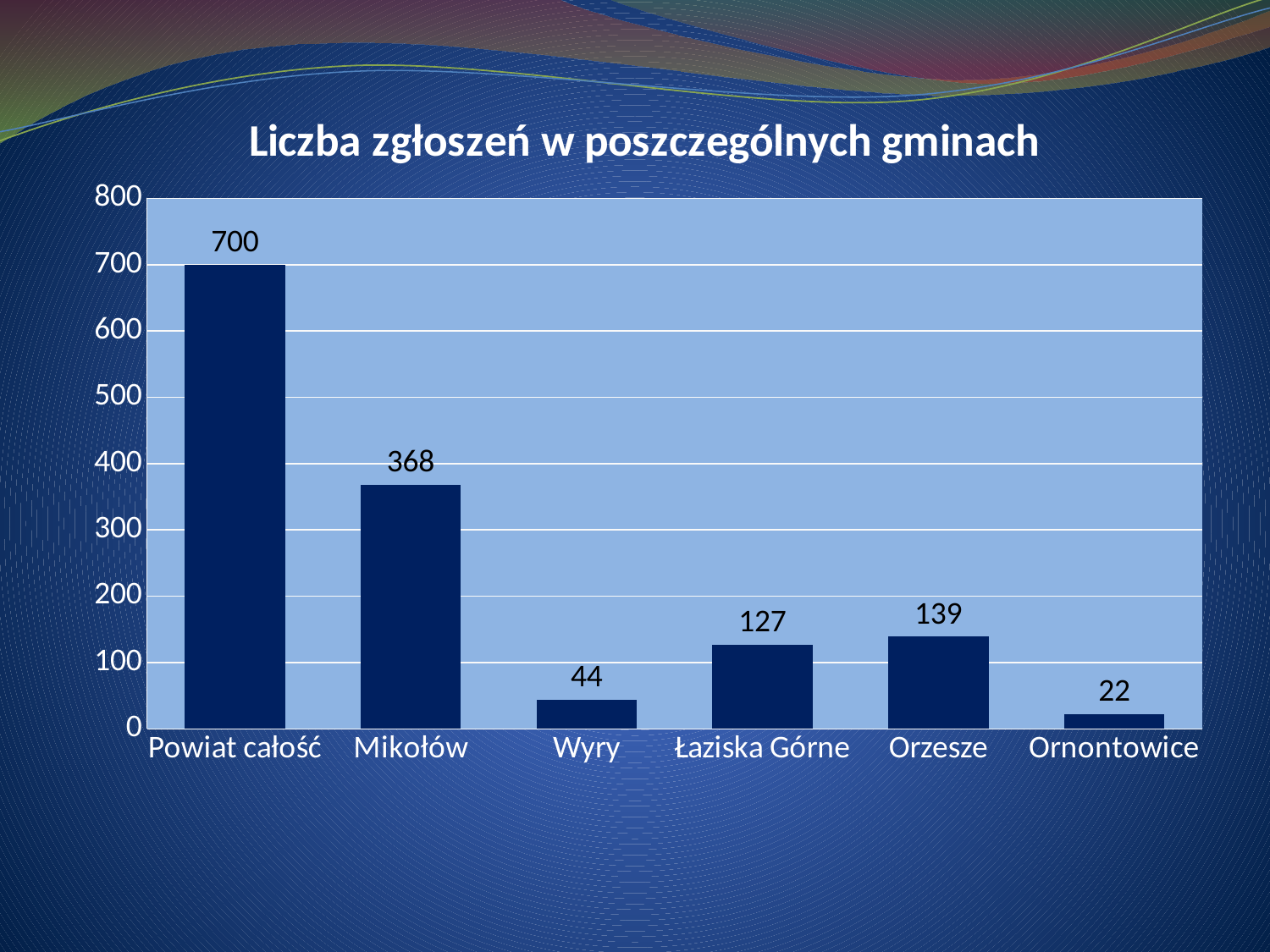
Which category has the highest value? Powiat całość What is the value for Mikołów? 368 What is the value for Ornontowice? 22 How many categories are shown on the x axis? 6 What kind of chart is shown on the slide? bar chart Is the value for Mikołów greater or less than 300? greater What is the difference between the values for Orzesze and Łaziska Górne? 12 Which category has the lowest value? Ornontowice What is the difference between the values for Powiat całość and Mikołów? 332 What is the value for Łaziska Górne? 127 What is the title of the chart? Liczba zgłoszeń w poszczególnych gminach Which is larger, the value for Wyry or the value for Orzesze? Orzesze